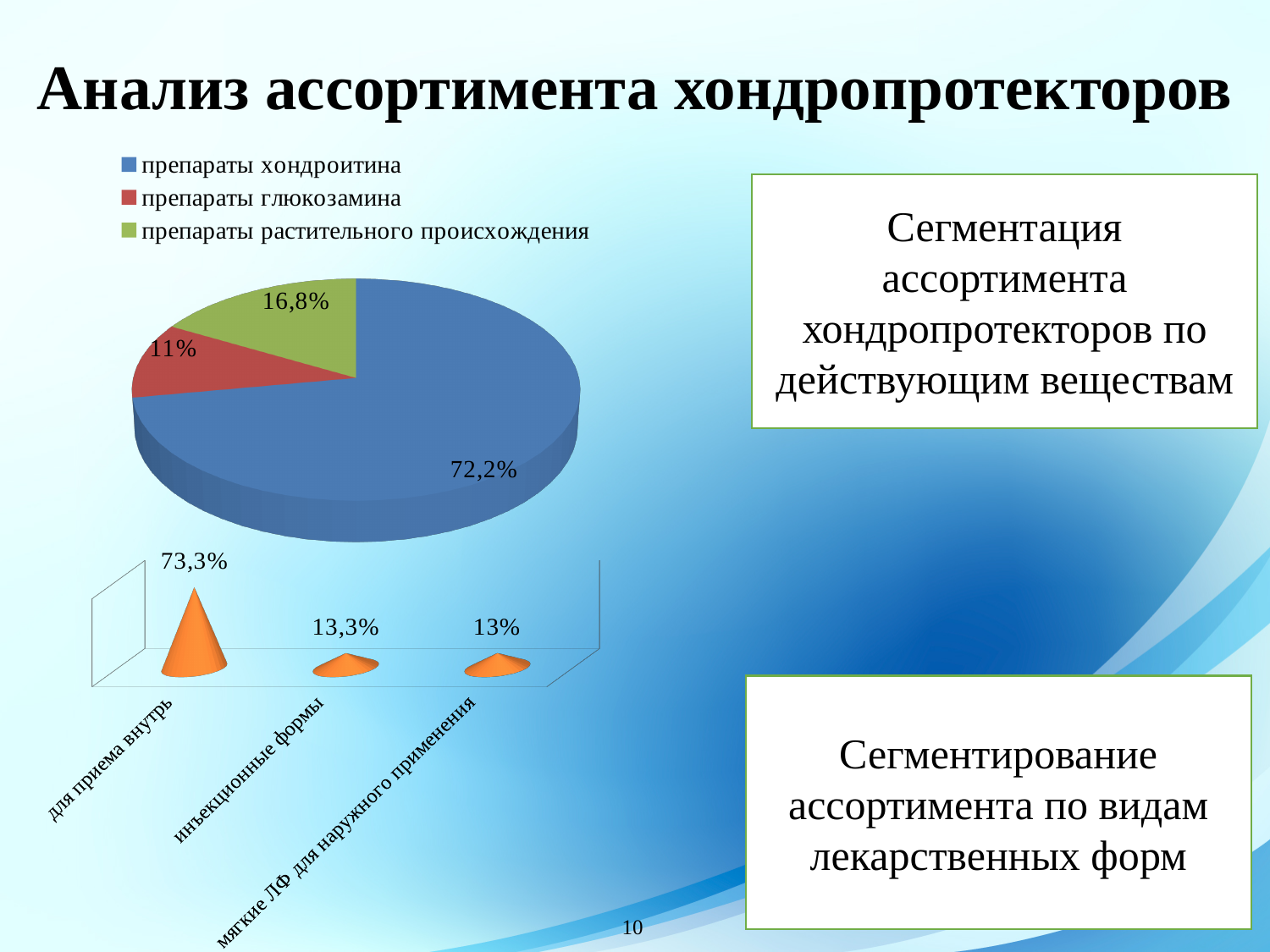
In the top pie chart, which category has the largest slice? препараты хондроитина In the bottom chart, what value is shown for мягкие ЛФ для наружного применения? 13% In the bottom chart, how many categories are plotted? 3 In the top pie chart, what share is shown for препараты глюкозамина? 11% In the bottom chart, what value is shown for инъекционные формы? 13,3% In the top pie chart, which category has the smallest slice? препараты глюкозамина In the top pie chart, what share is shown for препараты хондроитина? 72,2% In the bottom chart, which category has the highest value? для приема внутрь In the top pie chart, what colour is the slice for препараты растительного происхождения? green In the bottom chart, what value is shown for для приема внутрь? 73,3% In the top pie chart, what share is shown for препараты растительного происхождения? 16,8% In the top pie chart, how many entries does the legend list? 3